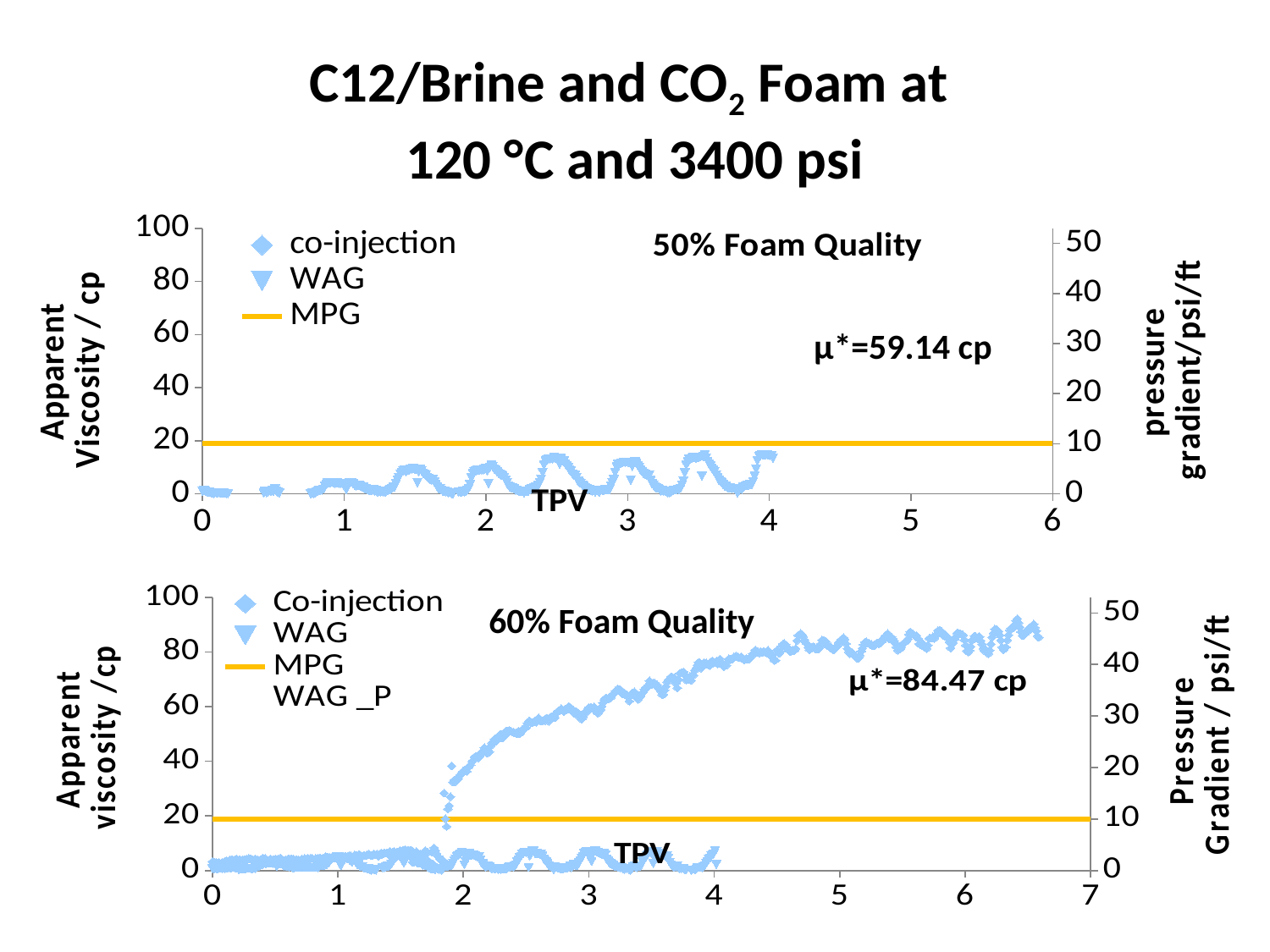
How many series does the legend of the top chart (50% Foam Quality) list? 3 In the bottom chart (60% Foam Quality), what is the value of μ* printed on the chart? 84.47 cp In the top chart (50% Foam Quality), is the co-injection apparent viscosity at TPV 3 greater or less than 20 cp? less How many charts are shown on the slide? 2 What kind of chart is the bottom chart (60% Foam Quality)? scatter chart In the bottom chart (60% Foam Quality), does the Co-injection apparent viscosity rise or fall as TPV increases from 2 to 6? rise How many series does the legend of the bottom chart (60% Foam Quality) list? 4 What is the difference between the μ* values printed on the 60% Foam Quality chart and the 50% Foam Quality chart? 25.33 cp In the bottom chart (60% Foam Quality), is the Co-injection apparent viscosity at TPV 6 greater or less than 60 cp? greater What is the label of the right-hand vertical axis of the top chart (50% Foam Quality)? pressure gradient/psi/ft In the top chart (50% Foam Quality), what is the value of μ* printed on the chart? 59.14 cp Which chart reports the larger μ* value, the 50% Foam Quality chart or the 60% Foam Quality chart? 60% Foam Quality